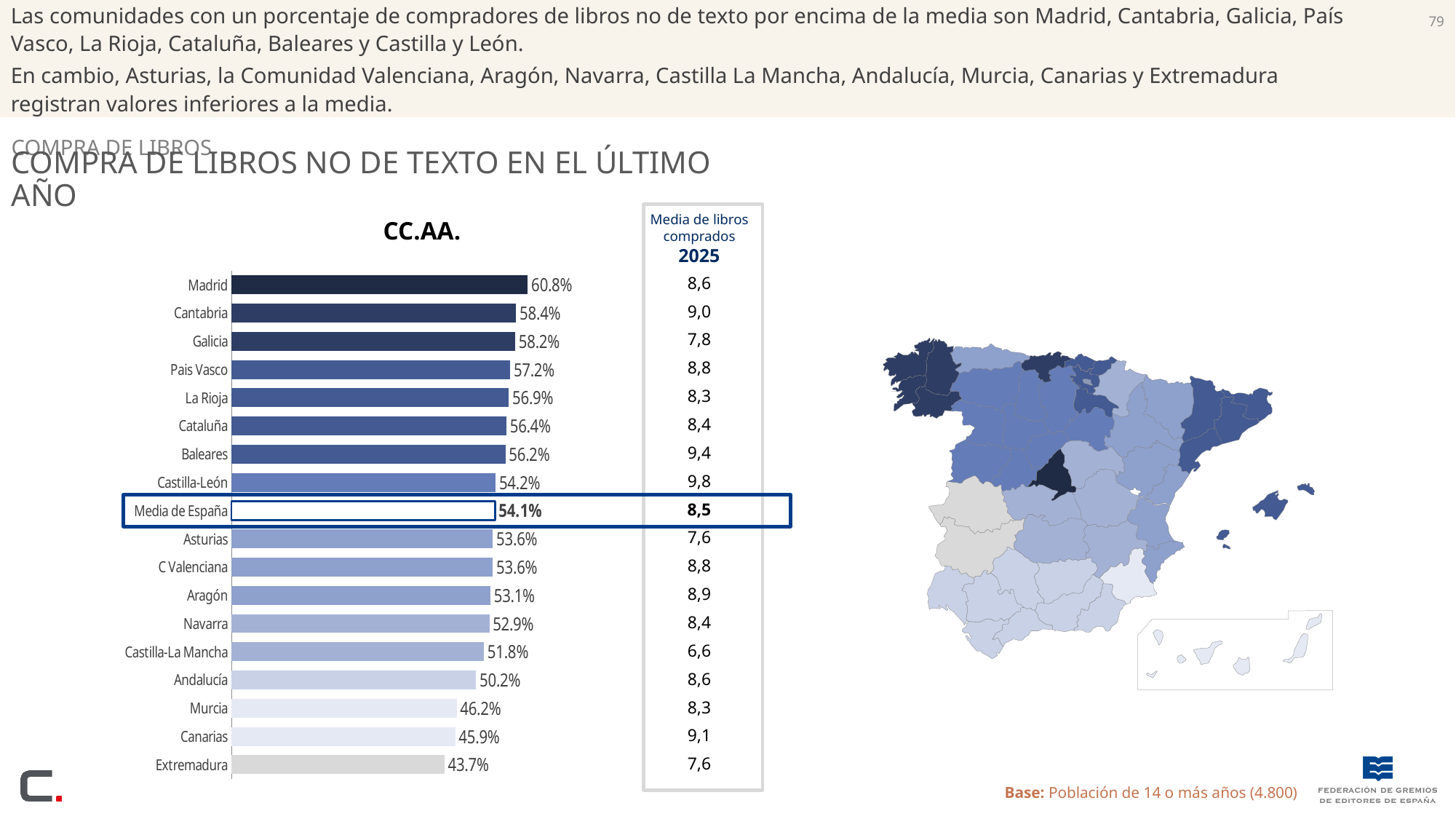
In the CC.AA. bar chart, what is the value for Canarias? 45.9% What kind of chart is the CC.AA. chart? Bar chart In the CC.AA. bar chart, which is larger, the value for Baleares or the value for Andalucía? Baleares In the CC.AA. bar chart, what is the value for Castilla-La Mancha? 51.8% In the CC.AA. bar chart, what is the value for Madrid? 60.8% In the CC.AA. bar chart, what is the value for Media de España? 54.1% In the CC.AA. bar chart, what is the difference between the values for Castilla-León and Media de España? 0.1 percentage points In the CC.AA. bar chart, which community has the highest value? Madrid How many bars are shown in the CC.AA. bar chart, including the Media de España bar? 18 In the CC.AA. bar chart, what is the difference between the values for Madrid and Extremadura? 17.1 percentage points In the CC.AA. bar chart, which bar is outlined with a dark blue box? Media de España In the CC.AA. bar chart, which community has the lowest value? Extremadura